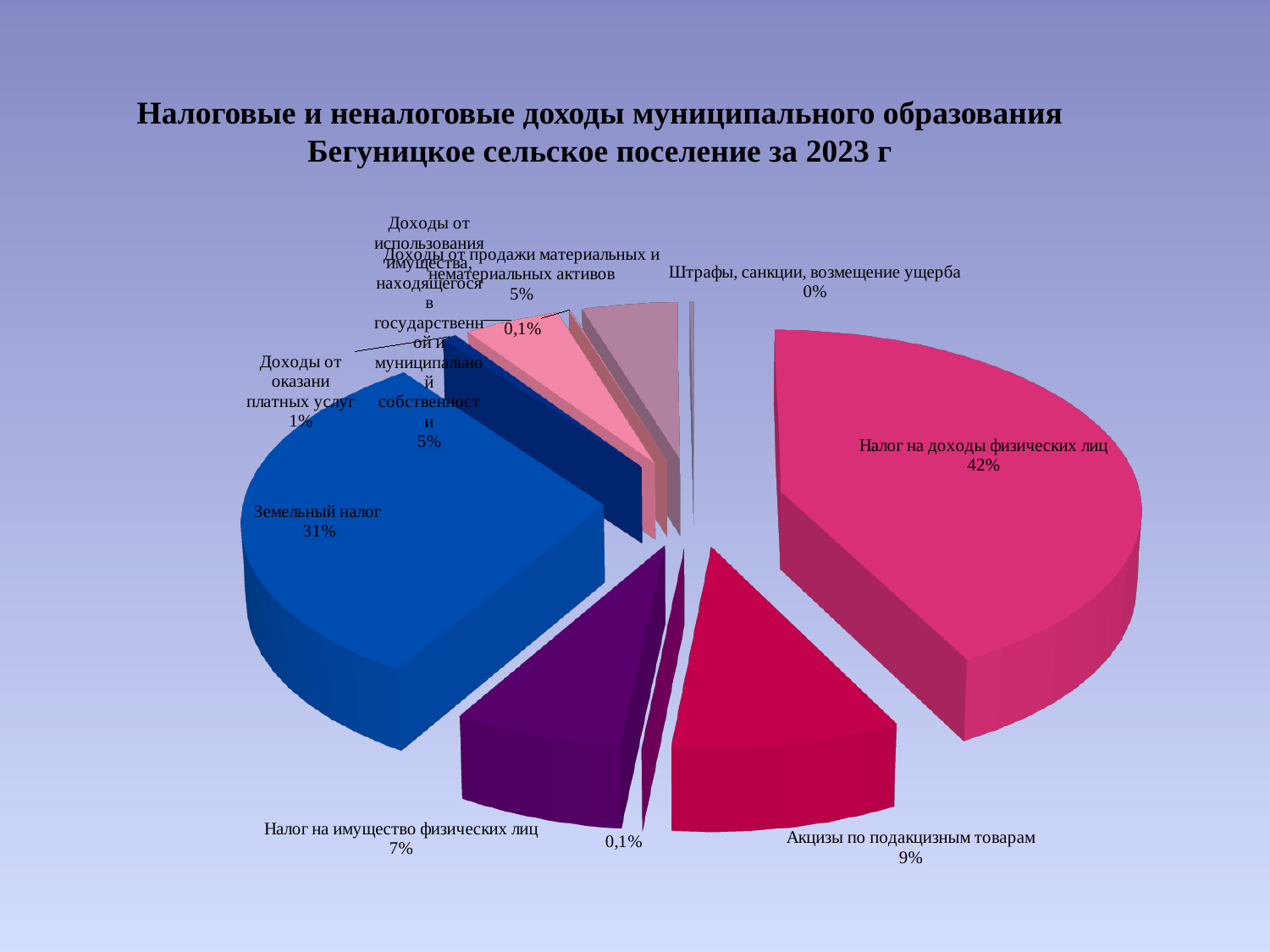
What is the value shown for Доходы от оказания платных услуг? 1% What is the value shown for Штрафы, санкции, возмещение ущерба? 0% What is the title of the chart? Налоговые и неналоговые доходы муниципального образования Бегуницкое сельское поселение за 2023 г Which category has the largest share of the pie? Налог на доходы физических лиц What share of the pie does Земельный налог have? 31% What is the value shown for Налог на имущество физических лиц? 7% What is the difference between the shares of Налог на доходы физических лиц and Земельный налог? 11% What share of the pie does Налог на доходы физических лиц have? 42% Which is larger: the share of Акцизы по подакцизным товарам or the share of Налог на имущество физических лиц? Акцизы по подакцизным товарам What is the value shown for Доходы от продажи материальных и нематериальных активов? 5% What kind of chart is shown on the slide? pie chart What is the value shown for Акцизы по подакцизным товарам? 9%